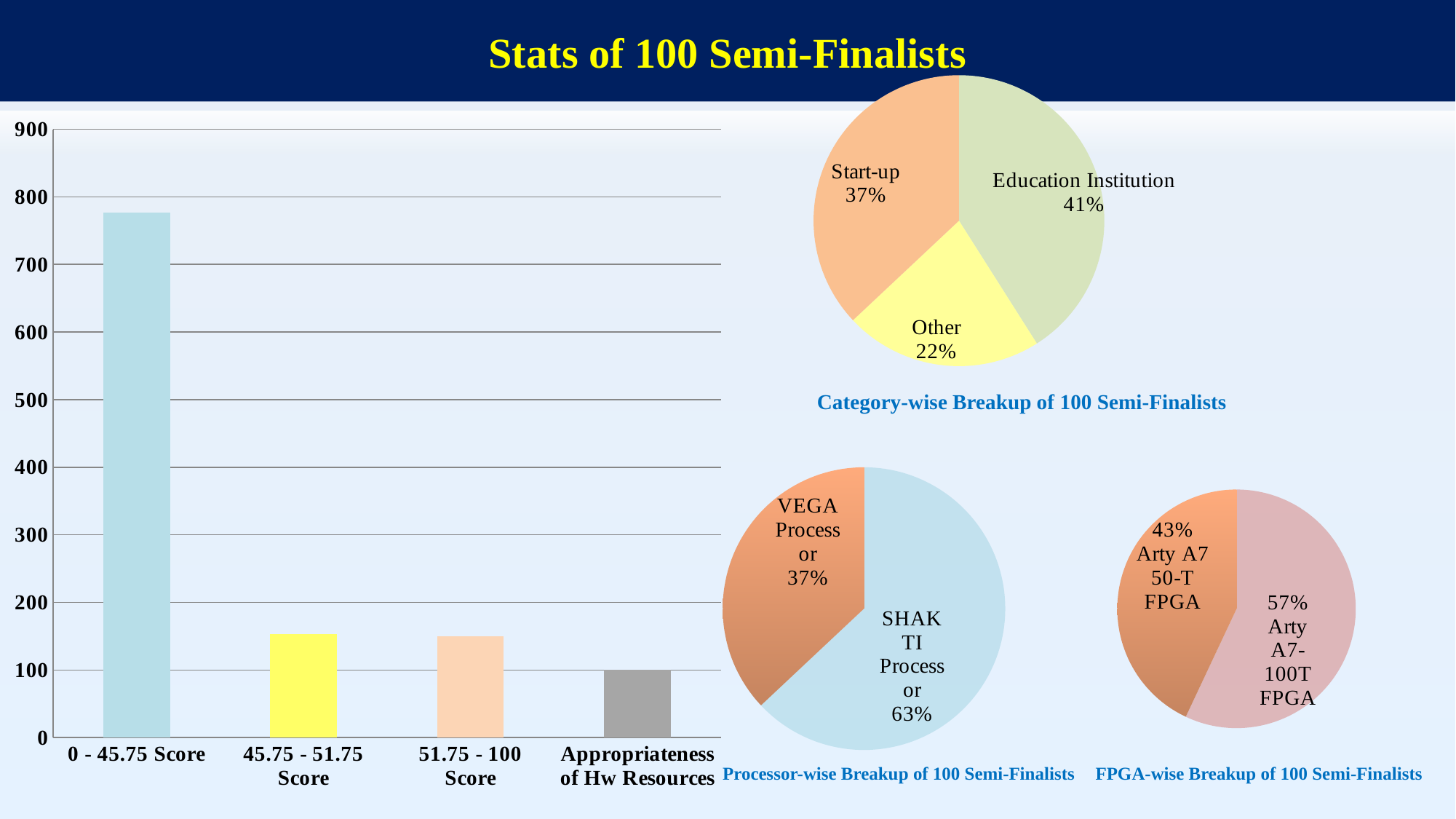
How many categories does the bar chart on the left side of the slide show? 4 In the bar chart on the left, is the value for 51.75 - 100 Score greater or less than 200? less How many pie charts are shown on the slide? 3 In the Category-wise Breakup of 100 Semi-Finalists pie chart, what is the difference between the Education Institution and Start-up shares? 4% In the FPGA-wise Breakup of 100 Semi-Finalists pie chart, which slice is larger: Arty A7 50-T FPGA or Arty A7-100T FPGA? Arty A7-100T FPGA In the Category-wise Breakup of 100 Semi-Finalists pie chart, what share is Education Institution? 41% In the bar chart on the left, which category has the highest value? 0 - 45.75 Score In the bar chart on the left, which category has the lowest value? Appropriateness of Hw Resources In the bar chart on the left, is the value for 0 - 45.75 Score greater or less than 700? greater In the Processor-wise Breakup of 100 Semi-Finalists pie chart, what share is SHAKTI Processor? 63% In the Category-wise Breakup of 100 Semi-Finalists pie chart, which category has the smallest share? Other What type of chart is the chart on the left side of the slide? bar chart